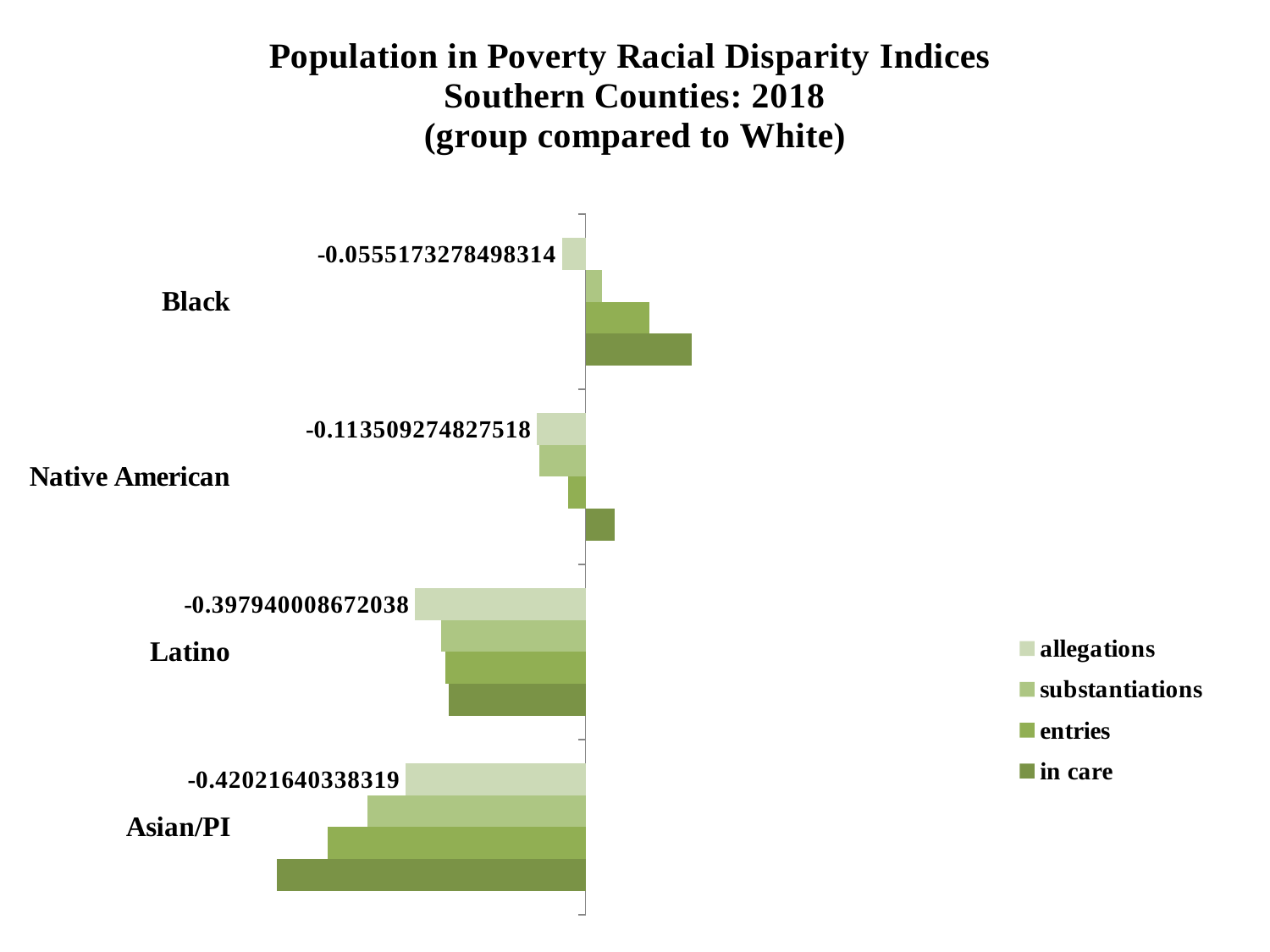
How many series does the legend list? 4 Which group has the lowest allegations value? Asian/PI Which series is shown in the darkest green in the legend? in care Which is larger, the allegations value for Native American or the allegations value for Latino? Native American How many groups (categories) are shown on the chart? 4 What is the allegations value for Asian/PI? -0.42021640338319 Which group has the highest allegations value? Black What is the allegations value for Latino? -0.397940008672038 What is the allegations value for Native American? -0.113509274827518 Which is larger, the in care value for Black or the in care value for Latino? Black What type of chart is shown on the slide? Bar chart What is the allegations value for Black? -0.0555173278498314